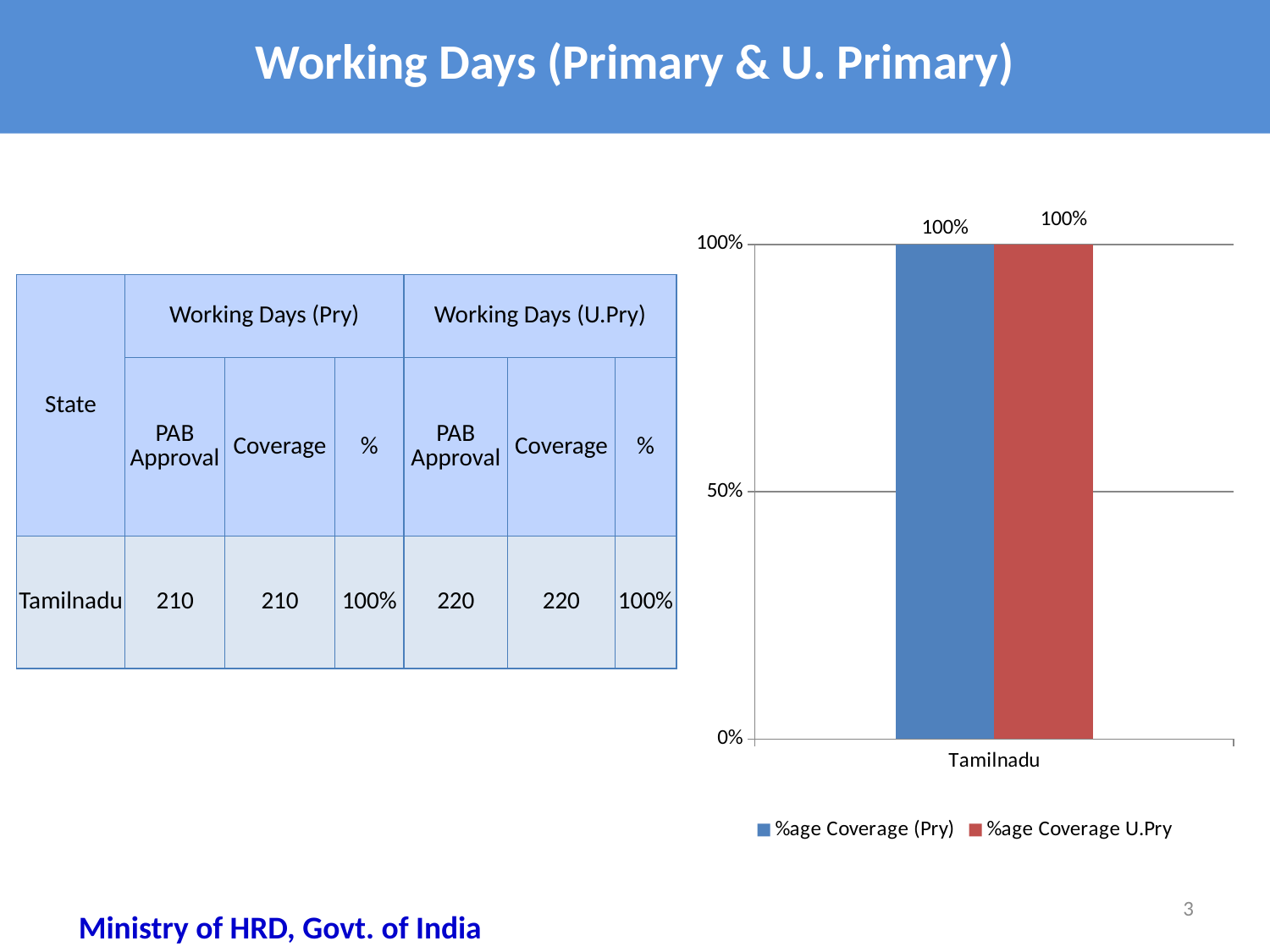
What colour is the %age Coverage U.Pry bar in the chart? red How many categories are shown on the x axis of the chart? 1 How many series does the chart legend list? 2 Which category is shown on the x axis of the chart? Tamilnadu What is the value of %age Coverage U.Pry for Tamilnadu in the chart? 100% What is the value of %age Coverage (Pry) for Tamilnadu in the chart? 100% What is the difference between %age Coverage (Pry) and %age Coverage U.Pry for Tamilnadu? 0% Is the value for %age Coverage U.Pry for Tamilnadu greater or less than 50%? greater Is the value for %age Coverage (Pry) for Tamilnadu greater or less than 50%? greater What kind of chart is shown on the slide? bar chart